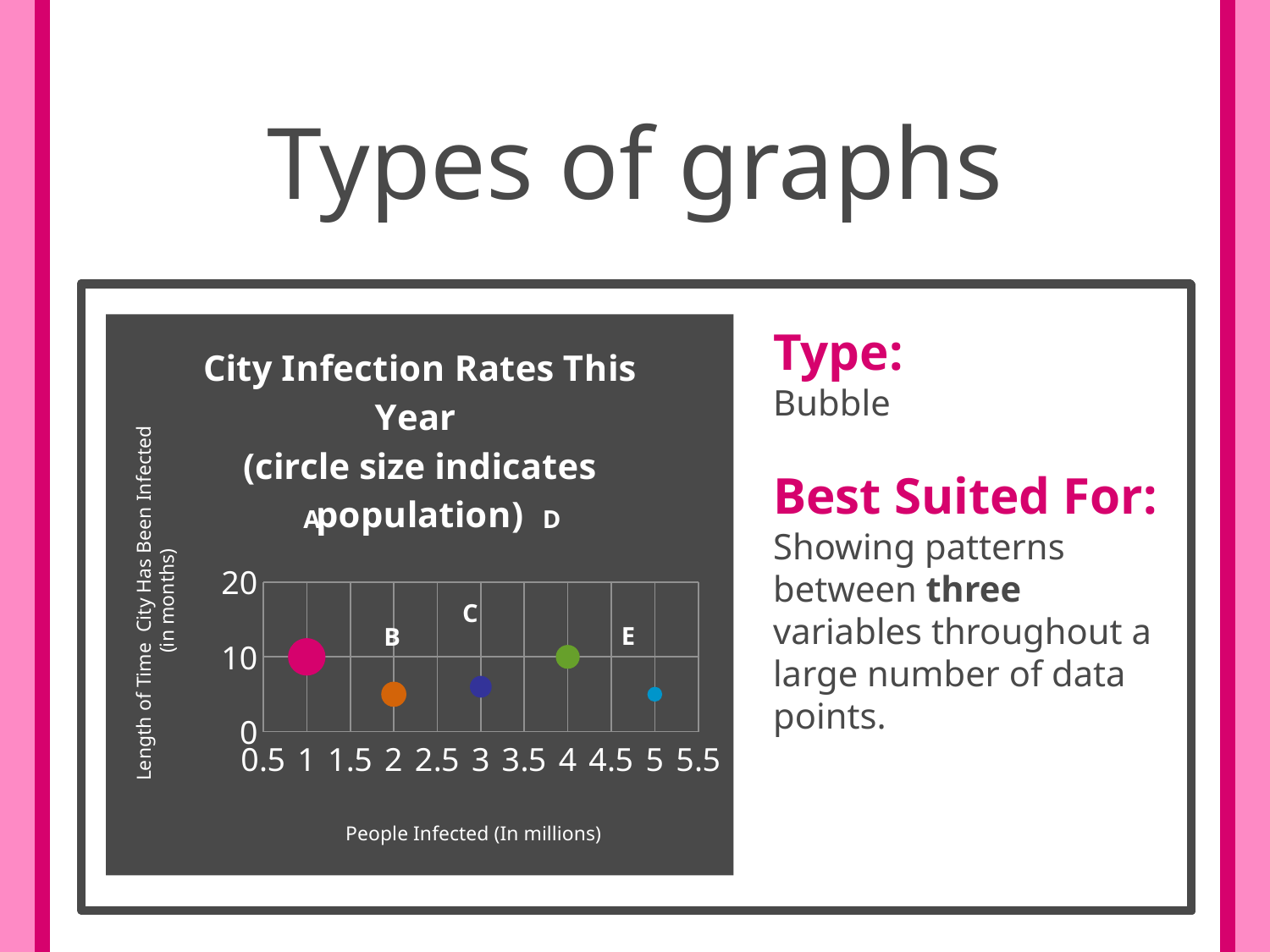
What is the label of the x axis of the chart? People Infected (In millions) According to the chart title, what does the circle size indicate? Population What kind of chart is shown on the slide? Bubble chart How many months has the city represented by the pink bubble been infected? 10 Is the length of time infected for the light blue bubble (at 5 million people infected) greater or less than 10 months? less How many bubbles are plotted on the chart? 5 At what x-axis value (people infected, in millions) is the large pink bubble plotted? 1 Which bubble is the largest on the chart? The pink bubble at 1 million people infected Which bubble is the smallest on the chart? The light blue bubble at 5 million people infected Is the length of time infected for the orange bubble (at 2 million people infected) greater or less than 10 months? less At what x-axis value (people infected, in millions) is the green bubble plotted? 4 Which has been infected longer: the city shown by the pink bubble or the city shown by the orange bubble? The pink bubble